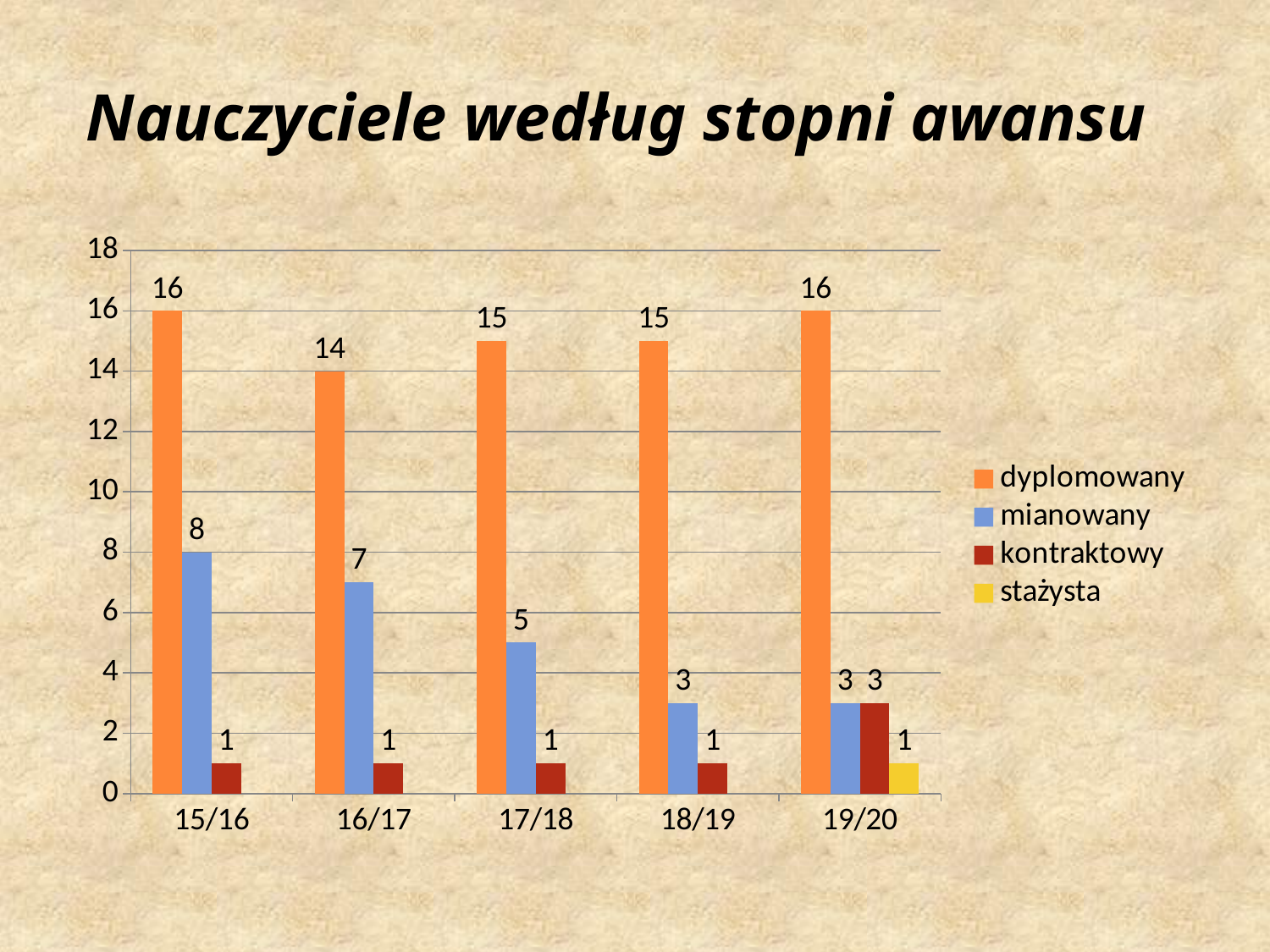
In which year is the dyplomowany value lowest? 16/17 What is the value for stażysta in 19/20? 1 Does the mianowany value rise or fall from 15/16 to 18/19? fall In which year is the mianowany value lowest? 18/19 and 19/20 What is the difference between the dyplomowany and mianowany values in 16/17? 7 How many series does the legend list? 4 What is the value for mianowany in 17/18? 5 What kind of chart is shown on the slide? bar chart Which is larger in 18/19: mianowany or kontraktowy? mianowany How many years are shown on the x axis? 5 What is the value for dyplomowany in 15/16? 16 What is the value for kontraktowy in 19/20? 3